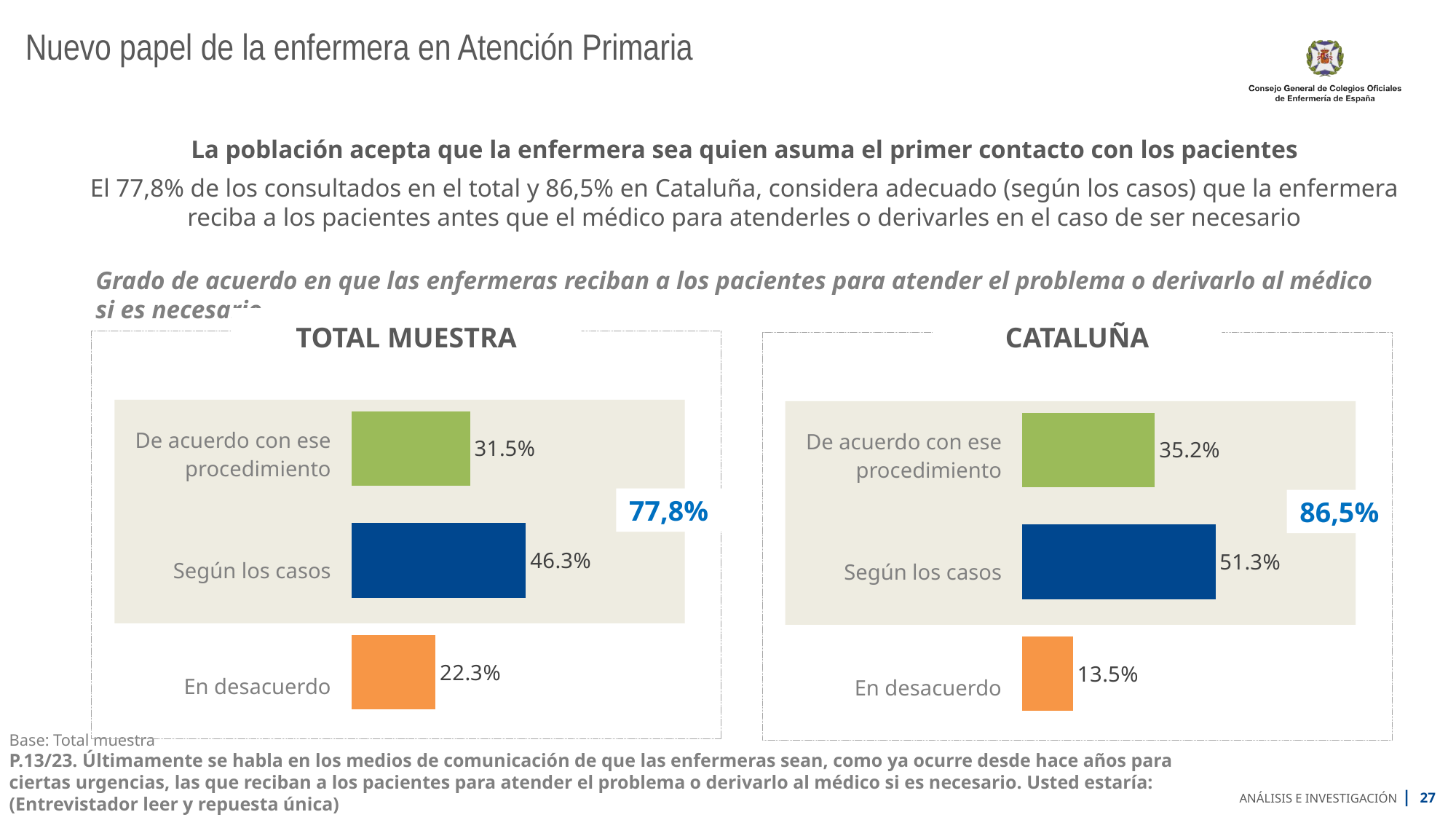
In the CATALUÑA chart, what is the difference between "Según los casos" and "En desacuerdo"? 37.8% In the CATALUÑA chart, which category has the lowest value? En desacuerdo What colour is the "Según los casos" bar in the CATALUÑA chart? Dark blue In the TOTAL MUESTRA chart, which category has the highest value? Según los casos In the TOTAL MUESTRA chart, what is the difference between "Según los casos" and "De acuerdo con ese procedimiento"? 14.8% In the CATALUÑA chart, what is the value for "En desacuerdo"? 13.5% What kind of chart is the CATALUÑA chart? Bar chart In the TOTAL MUESTRA chart, what is the value for "Según los casos"? 46.3% In the CATALUÑA chart, what is the value for "De acuerdo con ese procedimiento"? 35.2% How many categories does the TOTAL MUESTRA chart show? 3 Which is larger: "En desacuerdo" in the TOTAL MUESTRA chart or "En desacuerdo" in the CATALUÑA chart? TOTAL MUESTRA What combined percentage is highlighted in blue on the TOTAL MUESTRA chart? 77,8%